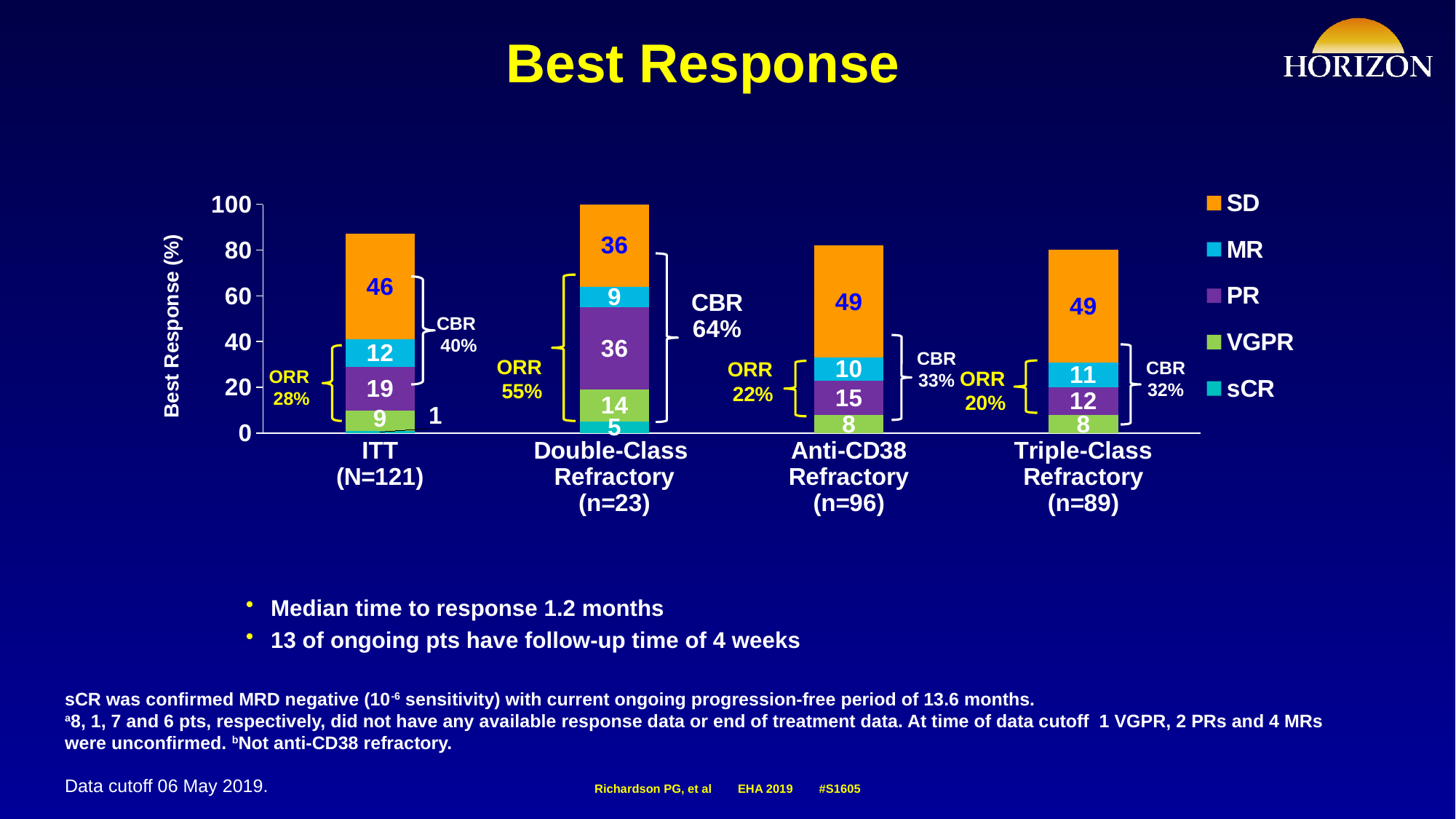
What is the total of the stacked bar for the Double-Class Refractory (n=23) group? 100 How many patient groups (categories) are plotted on the x axis? 4 Which group has the lowest CBR? Triple-Class Refractory (n=89) What is the PR value for the Double-Class Refractory (n=23) group? 36 What is the difference between the MR values for ITT (N=121) and Double-Class Refractory (n=23)? 3 What is the VGPR value for the Anti-CD38 Refractory (n=96) group? 8 What is the SD value for the ITT (N=121) group? 46 Which is larger, the PR value for Anti-CD38 Refractory (n=96) or the PR value for Triple-Class Refractory (n=89)? Anti-CD38 Refractory (n=96) Which group has the highest PR value? Double-Class Refractory (n=23) How many series does the legend list? 5 What type of chart is shown on the slide? Stacked bar chart What is the ORR shown for the Triple-Class Refractory (n=89) group? 20%